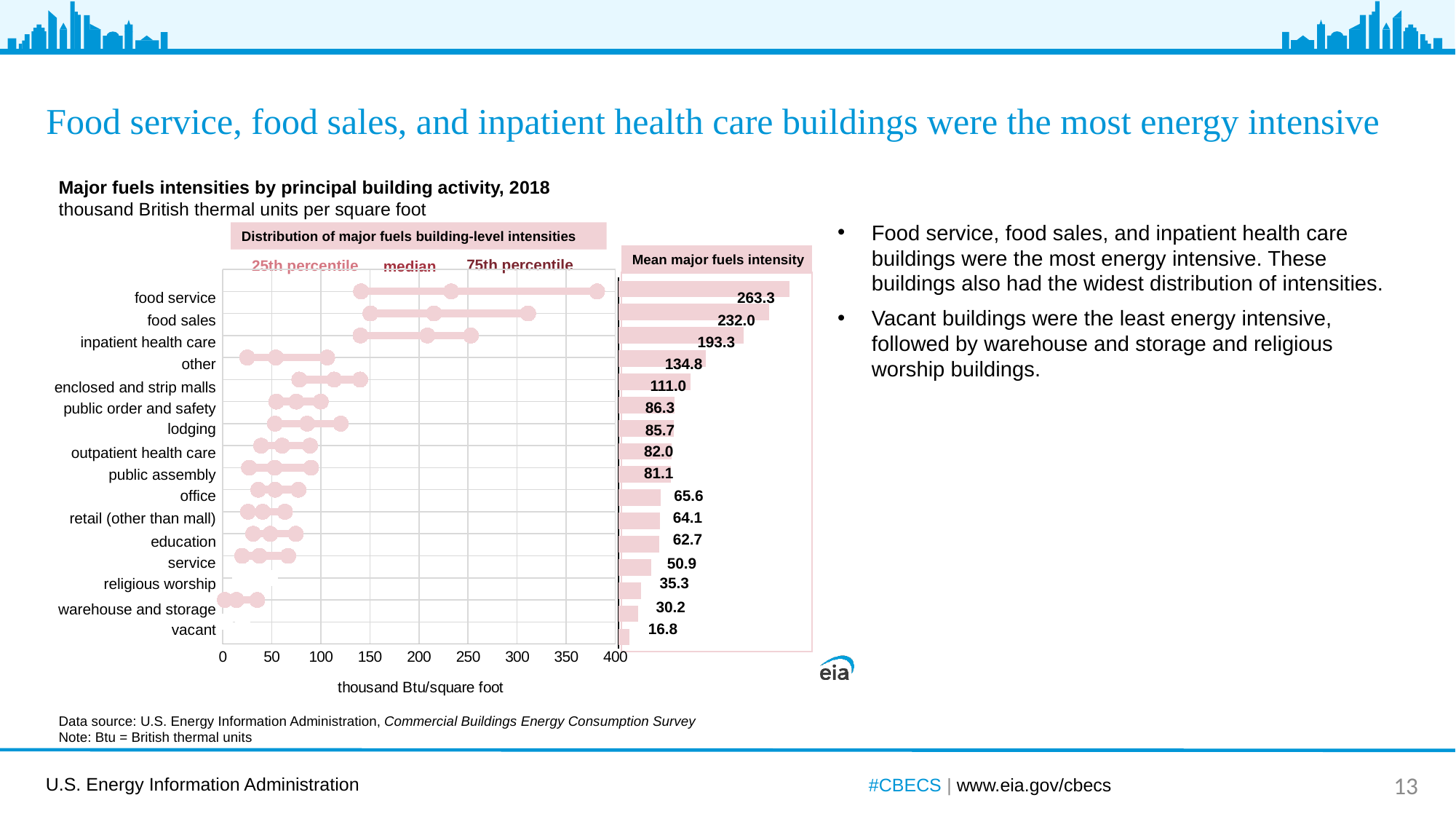
In the distribution plot, is the 25th percentile value for the 'other' category greater or less than 50? less Which building activity has the highest mean major fuels intensity? food service Which has a higher mean major fuels intensity, office or service buildings? office How many principal building activities are shown in the chart? 16 What is the mean major fuels intensity for food service buildings? 263.3 What is the difference between the mean major fuels intensity of food sales and inpatient health care buildings? 38.7 In the distribution plot, is the 75th percentile value for food service greater or less than 350? greater What unit is shown on the x axis of the distribution plot? thousand Btu/square foot How many series does the legend of the distribution plot list? 3 Which building activity has the lowest mean major fuels intensity? vacant What is the mean major fuels intensity for education buildings? 62.7 What is the mean major fuels intensity for lodging buildings? 85.7